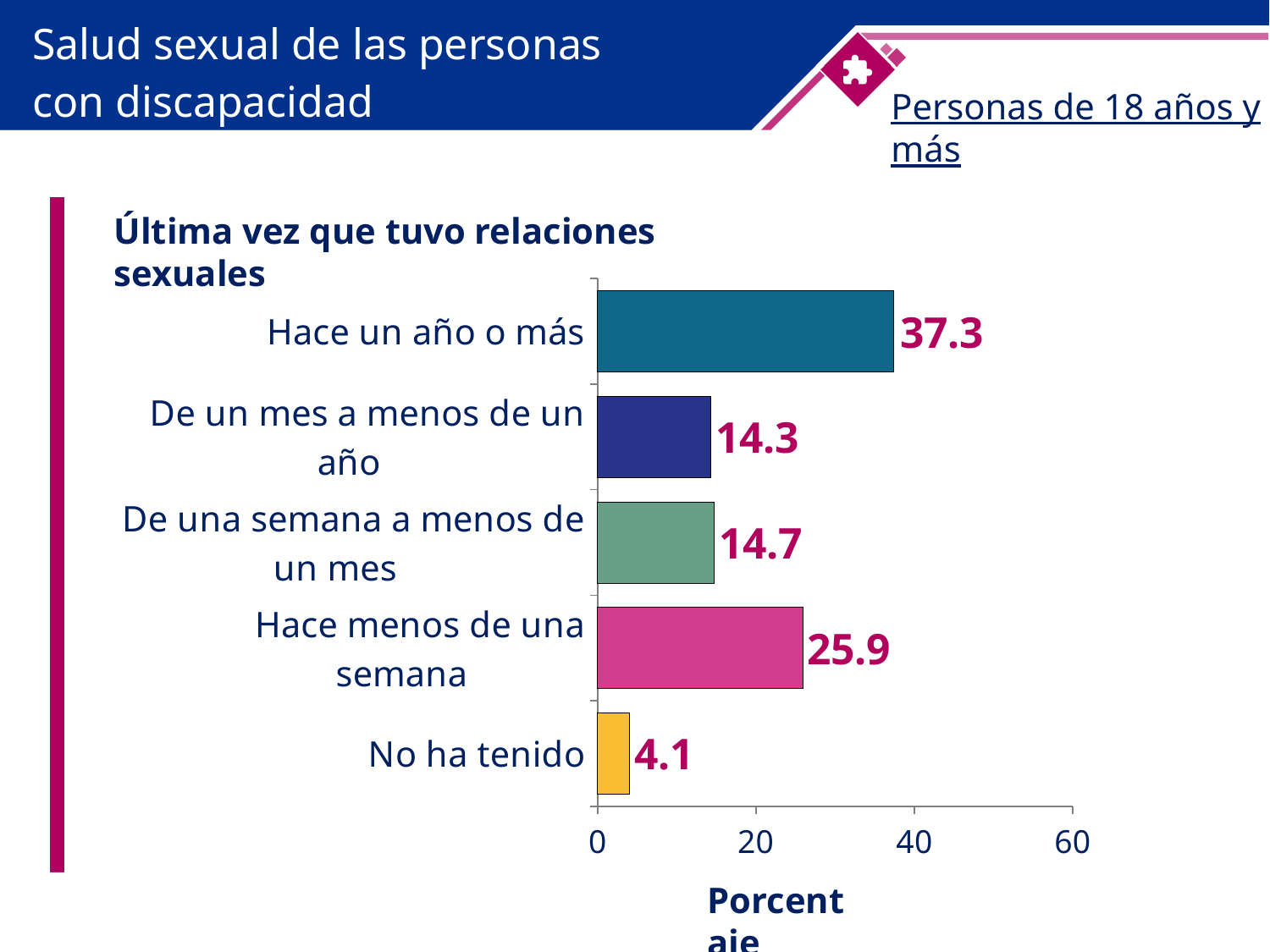
What is the value for "Hace un año o más"? 37.3 Which is larger: the value for "De un mes a menos de un año" or the value for "Hace menos de una semana"? Hace menos de una semana How many categories are shown in the chart? 5 What is the value for "Hace menos de una semana"? 25.9 Which category has the lowest value? No ha tenido Is the value for "Hace un año o más" greater or less than 40? less What kind of chart is shown on the slide? bar chart What is the difference between the values for "Hace un año o más" and "Hace menos de una semana"? 11.4 What is the title of the chart? Última vez que tuvo relaciones sexuales What is the value for "No ha tenido"? 4.1 What is the value for "De una semana a menos de un mes"? 14.7 Which category has the highest value? Hace un año o más